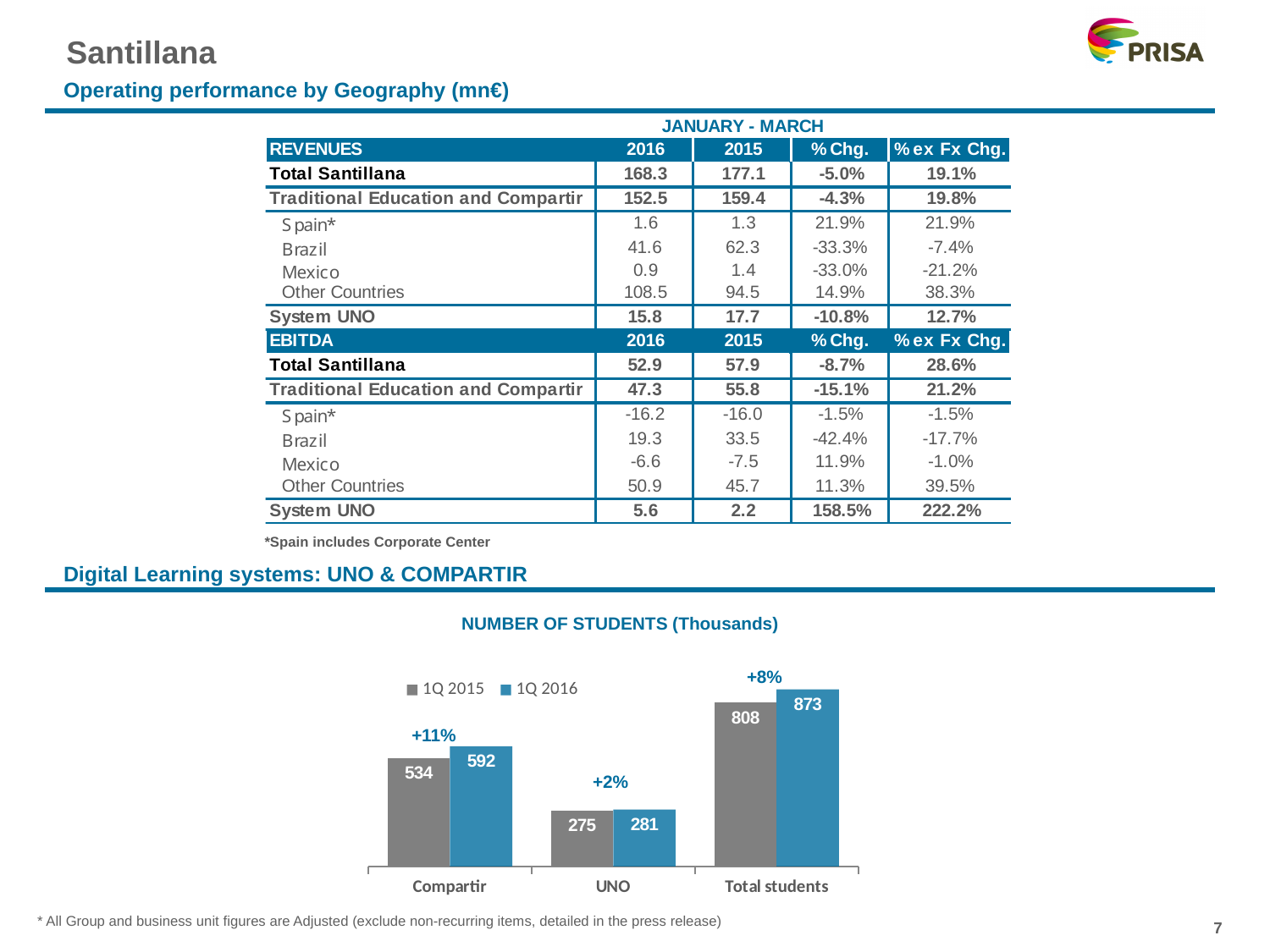
In the Number of Students chart, is the 1Q 2015 value for Compartir larger or smaller than the 1Q 2016 value for UNO? larger What is the 1Q 2016 value for Total students in the Number of Students chart? 873 Which category has the lowest 1Q 2015 value in the Number of Students chart? UNO What is the value for Compartir in the 1Q 2016 series of the Number of Students chart? 592 What is the difference between the 1Q 2016 and 1Q 2015 values for Total students in the Number of Students chart? 65 What percentage change is shown above the UNO bars in the Number of Students chart? +2% Which category has the highest 1Q 2016 value in the Number of Students chart? Total students How many categories are shown on the x axis of the Number of Students chart? 3 What kind of chart is the Number of Students chart? bar chart How many series does the legend of the Number of Students chart list? 2 What is the value for UNO in the 1Q 2015 series of the Number of Students chart? 275 What is the difference between the 1Q 2016 and 1Q 2015 values for Compartir in the Number of Students chart? 58